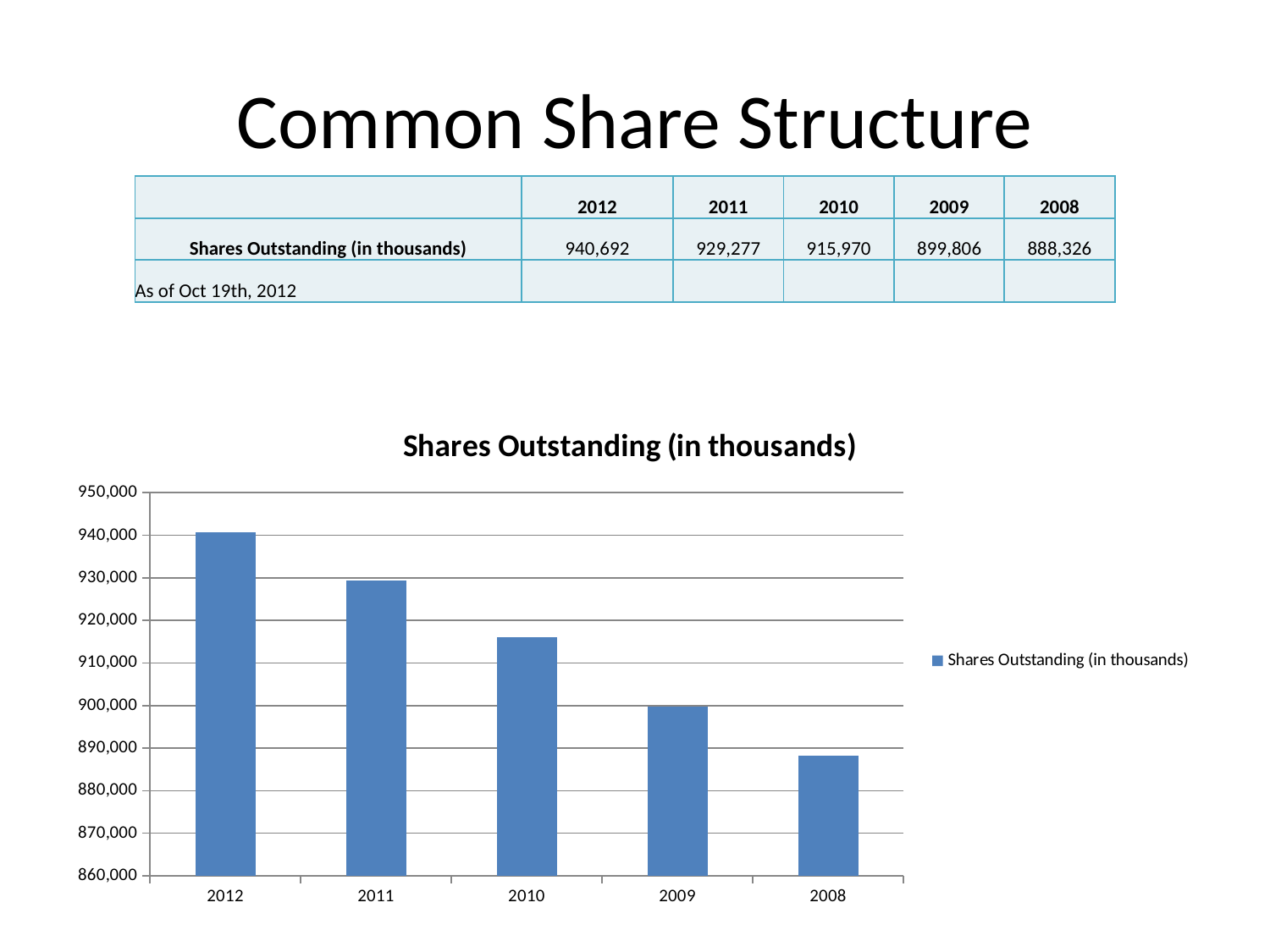
How many years are plotted on the x axis of the chart? 5 Do the values rise or fall moving from 2012 to 2008 along the x axis? fall Which year has the highest shares outstanding in the chart? 2012 What is the value of shares outstanding (in thousands) for 2012? 940,692 Which year has the lowest shares outstanding in the chart? 2008 What is the value of shares outstanding (in thousands) for 2008? 888,326 What type of chart is shown on the slide? bar chart What is the title of the chart? Shares Outstanding (in thousands) Is the value for 2009 greater or less than 900,000? less Is the value for 2010 greater or less than 910,000? greater How many series does the chart legend list? 1 Which is larger, the value for 2011 or the value for 2010? 2011